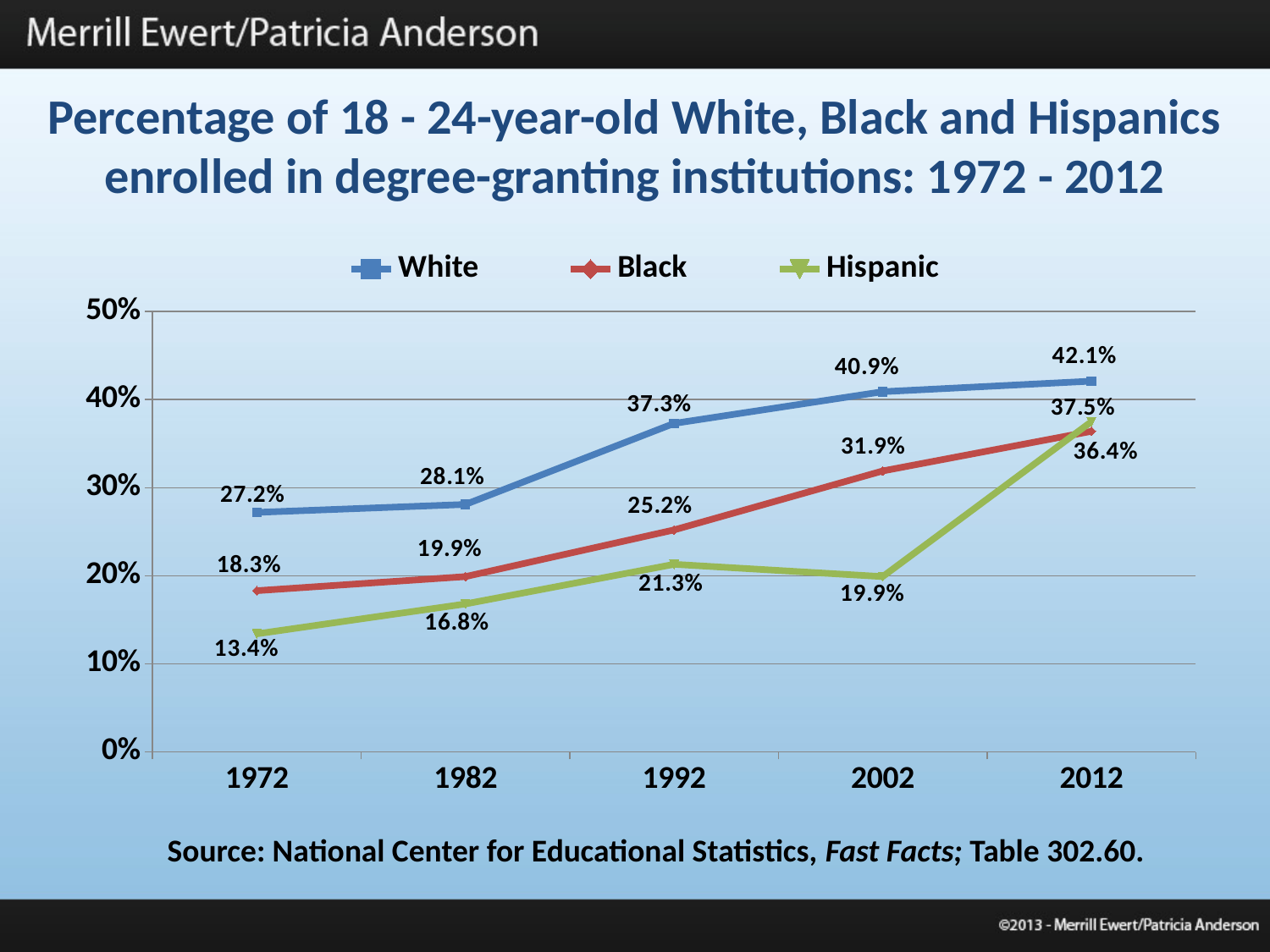
What is the difference between the White and Black enrollment percentages in 1992? 12.1% In which year was the Hispanic enrollment percentage highest? 2012 What kind of chart is shown on the slide? Line chart What percentage of 18-24-year-old White students were enrolled in 2012? 42.1% Which was larger in 2002, the Black or the Hispanic enrollment percentage? Black In which year was the White enrollment percentage lowest? 1972 Does the White enrollment percentage rise or fall from 1972 to 2012? Rise What was the Hispanic enrollment percentage in 1972? 13.4% Which colour is used for the Hispanic series? Green What was the Black enrollment percentage in 2002? 31.9% How many years are shown on the x axis? 5 How many series does the legend list? 3